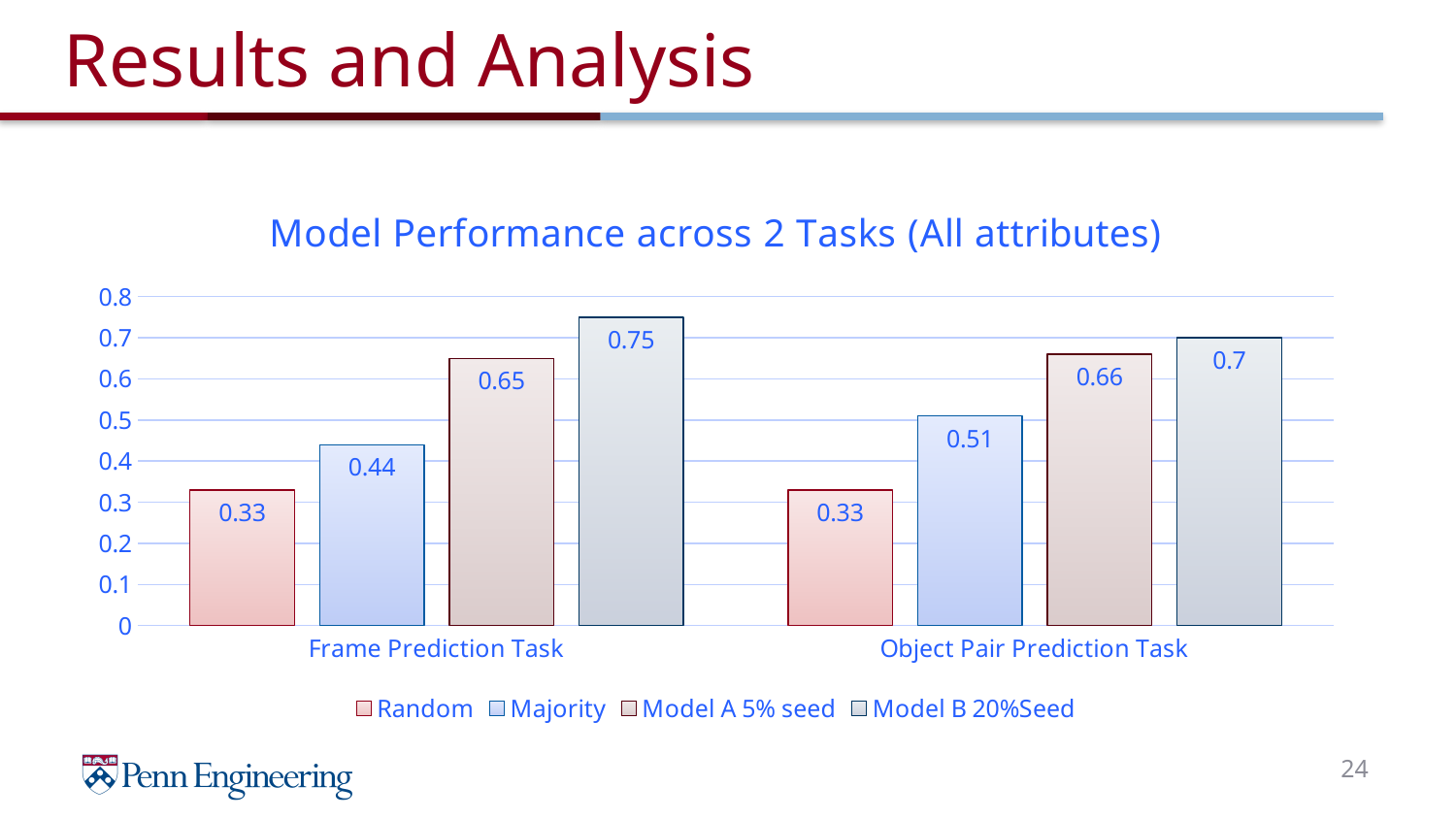
What kind of chart is shown on the slide? Bar chart What is the difference between Model A 5% seed and Majority on the Object Pair Prediction Task? 0.15 What is the difference between Model B 20%Seed and Random on the Frame Prediction Task? 0.42 What is the title of the chart? Model Performance across 2 Tasks (All attributes) Which series has the highest value on the Object Pair Prediction Task? Model B 20%Seed What is the value for Model A 5% seed on the Frame Prediction Task? 0.65 How many series does the legend list? 4 What is the value for Model B 20%Seed on the Frame Prediction Task? 0.75 Which series has the lowest value on the Frame Prediction Task? Random Which is larger: Majority on the Frame Prediction Task or Majority on the Object Pair Prediction Task? Object Pair Prediction Task What is the value for Majority on the Object Pair Prediction Task? 0.51 How many task categories are shown on the x axis? 2